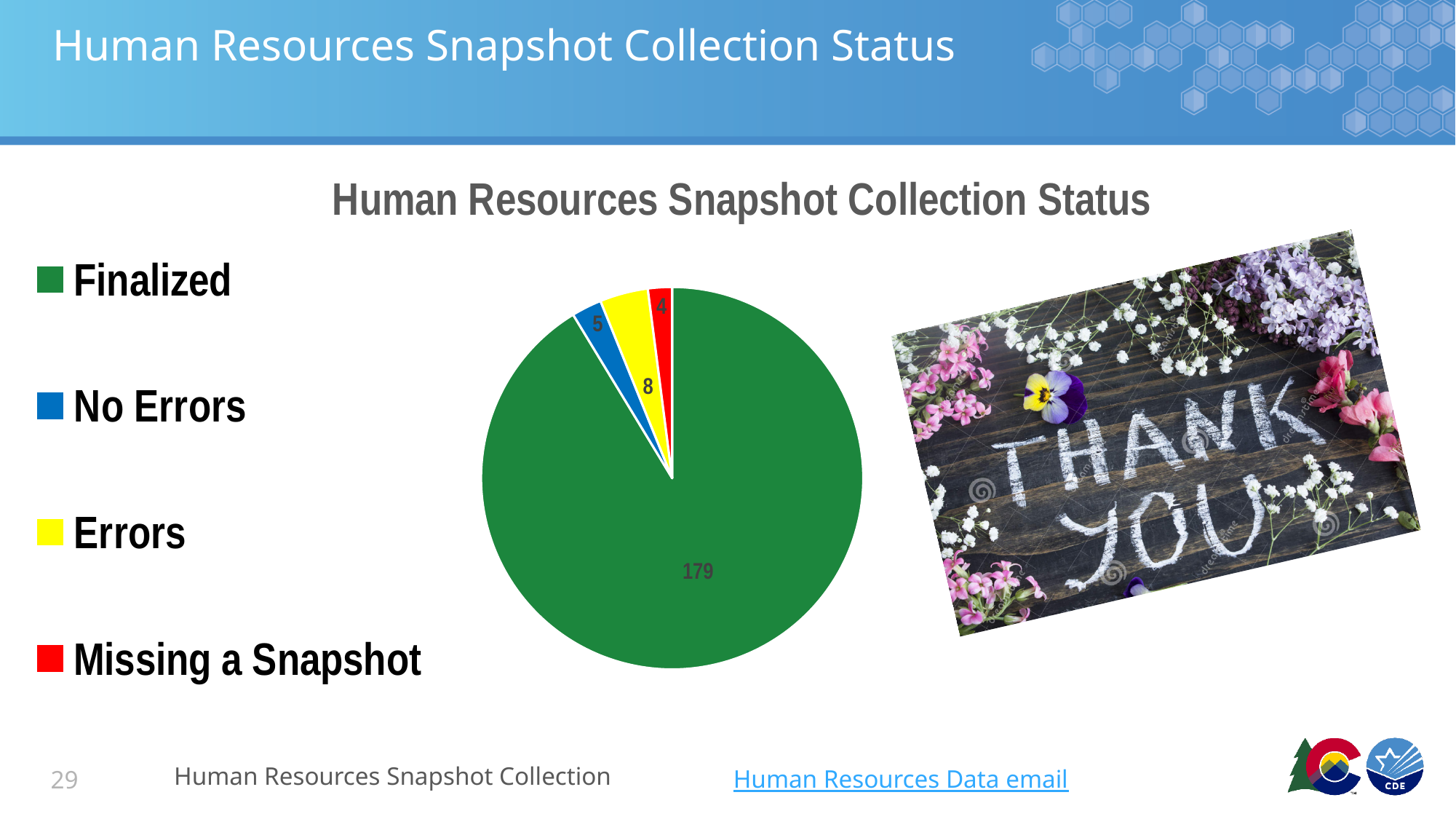
What is the value for Missing a Snapshot in the pie chart? 4 Which category has the largest slice in the pie chart? Finalized Which category has the smallest slice in the pie chart? Missing a Snapshot What is the total of all the slices in the pie chart? 196 What is the difference between the Finalized value and the Errors value? 171 What colour is the Errors slice in the pie chart? yellow What is the value for Errors in the pie chart? 8 What is the value for Finalized in the pie chart? 179 What type of chart is shown on the slide? pie chart What is the value for No Errors in the pie chart? 5 Which is larger, the value for Errors or the value for No Errors? Errors How many categories does the pie chart show? 4